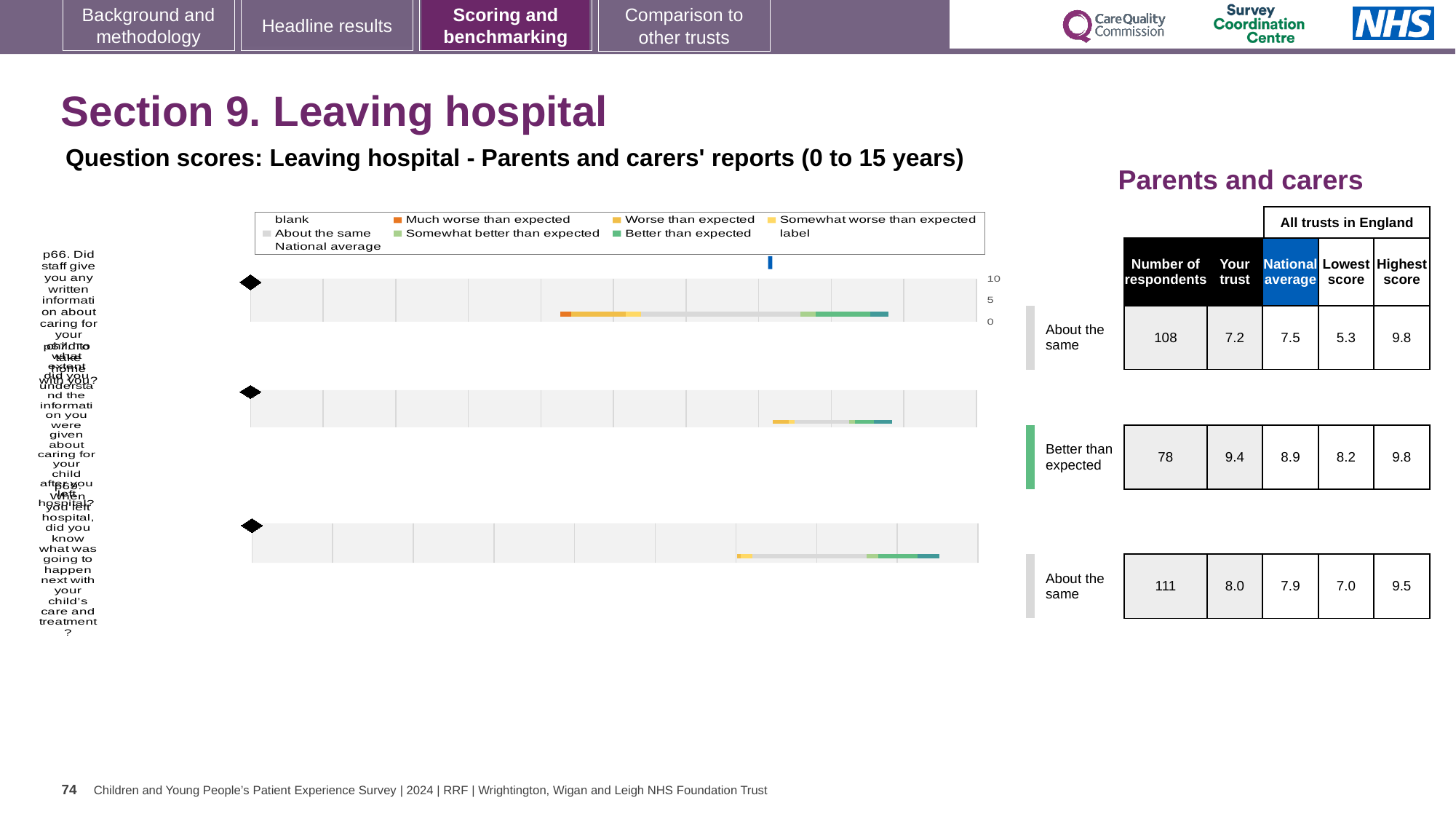
In the table next to the chart, what is the 'Your trust' score in the second row (Better than expected)? 9.4 How many horizontal bars (questions) are plotted in the chart? 3 In the second row of the table (Better than expected), which is larger: the 'Your trust' score or the national average? Your trust What colour represents 'Much worse than expected' in the chart legend? orange What kind of chart is shown on the slide? bar chart In the second row of the table (Better than expected), what is the difference between the 'Your trust' score and the national average? 0.5 In the table next to the chart, how many respondents are listed in the first row? 108 What is the highest tick value shown on the chart's score axis? 10 In the table next to the chart, what is the national average in the second row (Better than expected)? 8.9 In the table next to the chart, what is the lowest score in the first row? 5.3 How many entries does the chart legend list? 9 In the table next to the chart, what is the highest score in the third row? 9.5